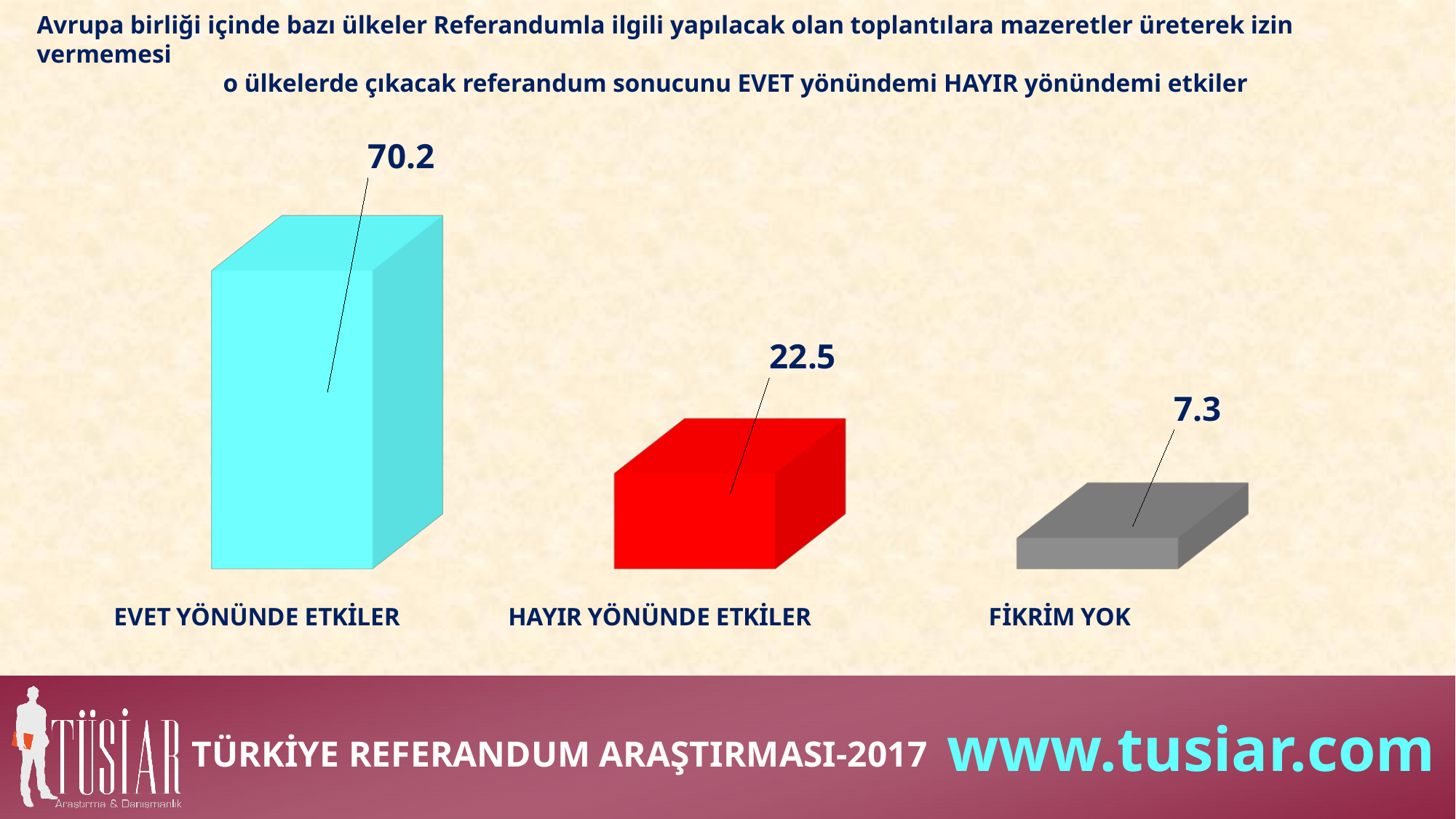
What is the difference between the values for EVET YÖNÜNDE ETKİLER and HAYIR YÖNÜNDE ETKİLER? 47.7 What kind of chart is shown on the slide? bar chart Which category has the highest value? EVET YÖNÜNDE ETKİLER Which category has the lowest value? FİKRİM YOK Which is larger, the value for HAYIR YÖNÜNDE ETKİLER or the value for FİKRİM YOK? HAYIR YÖNÜNDE ETKİLER What is the value for HAYIR YÖNÜNDE ETKİLER? 22.5 Do the values rise or fall from left to right across the categories? fall How many categories are shown in the chart? 3 What is the difference between the values for HAYIR YÖNÜNDE ETKİLER and FİKRİM YOK? 15.2 What is the value for EVET YÖNÜNDE ETKİLER? 70.2 What colour is the bar for HAYIR YÖNÜNDE ETKİLER? red What is the value for FİKRİM YOK? 7.3